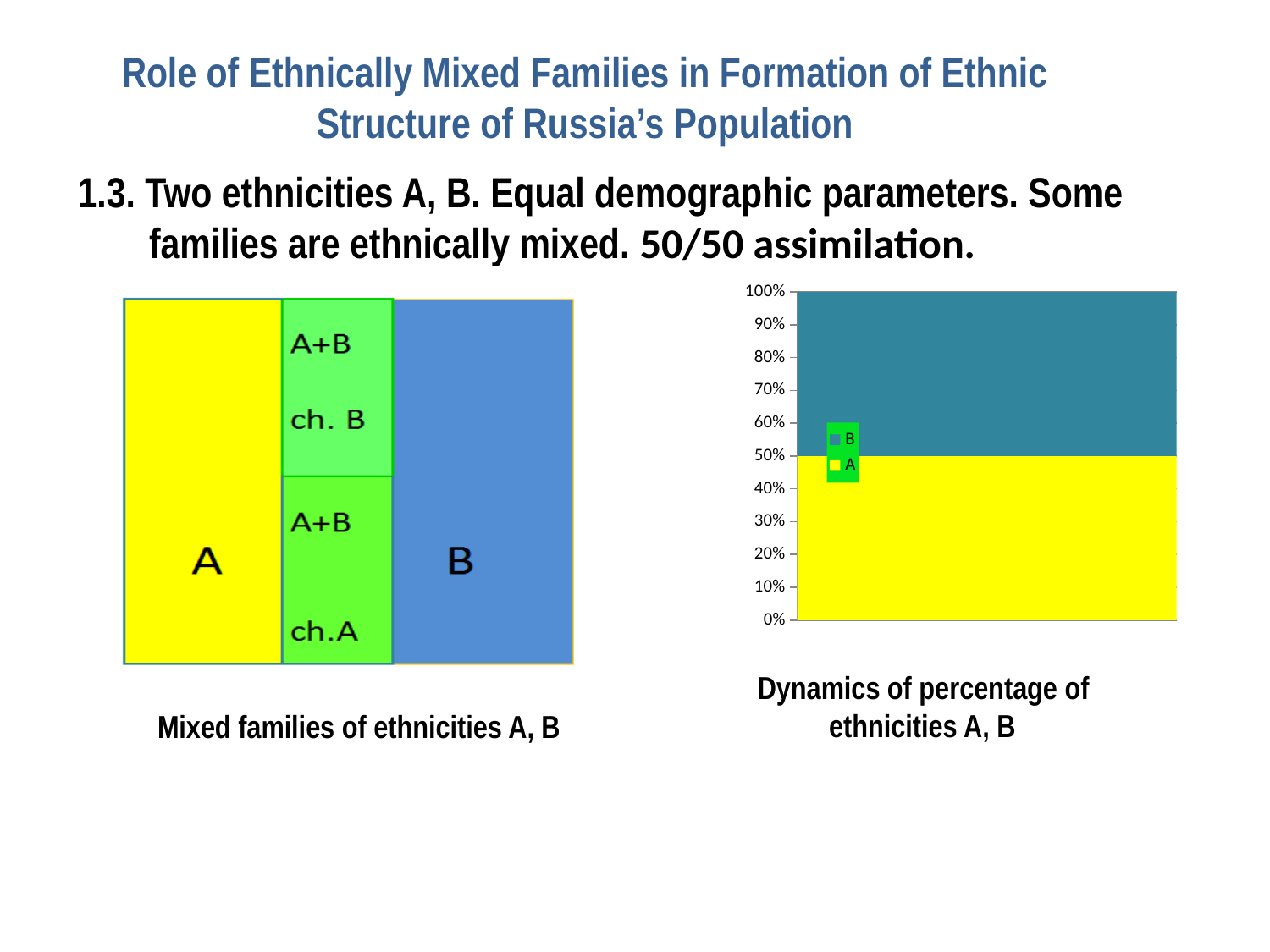
In the chart titled 'Dynamics of percentage of ethnicities A, B', does the percentage of ethnicity A rise, fall or stay constant along the x axis? Stays constant In the chart titled 'Dynamics of percentage of ethnicities A, B', what is the highest value shown on the vertical axis? 100% In the chart titled 'Dynamics of percentage of ethnicities A, B', what colour represents ethnicity A? Yellow In the chart titled 'Dynamics of percentage of ethnicities A, B', what is the combined total of the A and B shares? 100% In the chart titled 'Dynamics of percentage of ethnicities A, B', what kind of chart is it? Stacked area chart In the chart titled 'Dynamics of percentage of ethnicities A, B', is the share of ethnicity B greater or less than 70%? less In the chart titled 'Dynamics of percentage of ethnicities A, B', is the share of ethnicity A greater or less than 30%? greater In the chart titled 'Dynamics of percentage of ethnicities A, B', what are the legend entries? B, A In the chart titled 'Dynamics of percentage of ethnicities A, B', at what percentage does the boundary between A and B lie? 50% In the chart titled 'Dynamics of percentage of ethnicities A, B', how many series does the legend list? 2